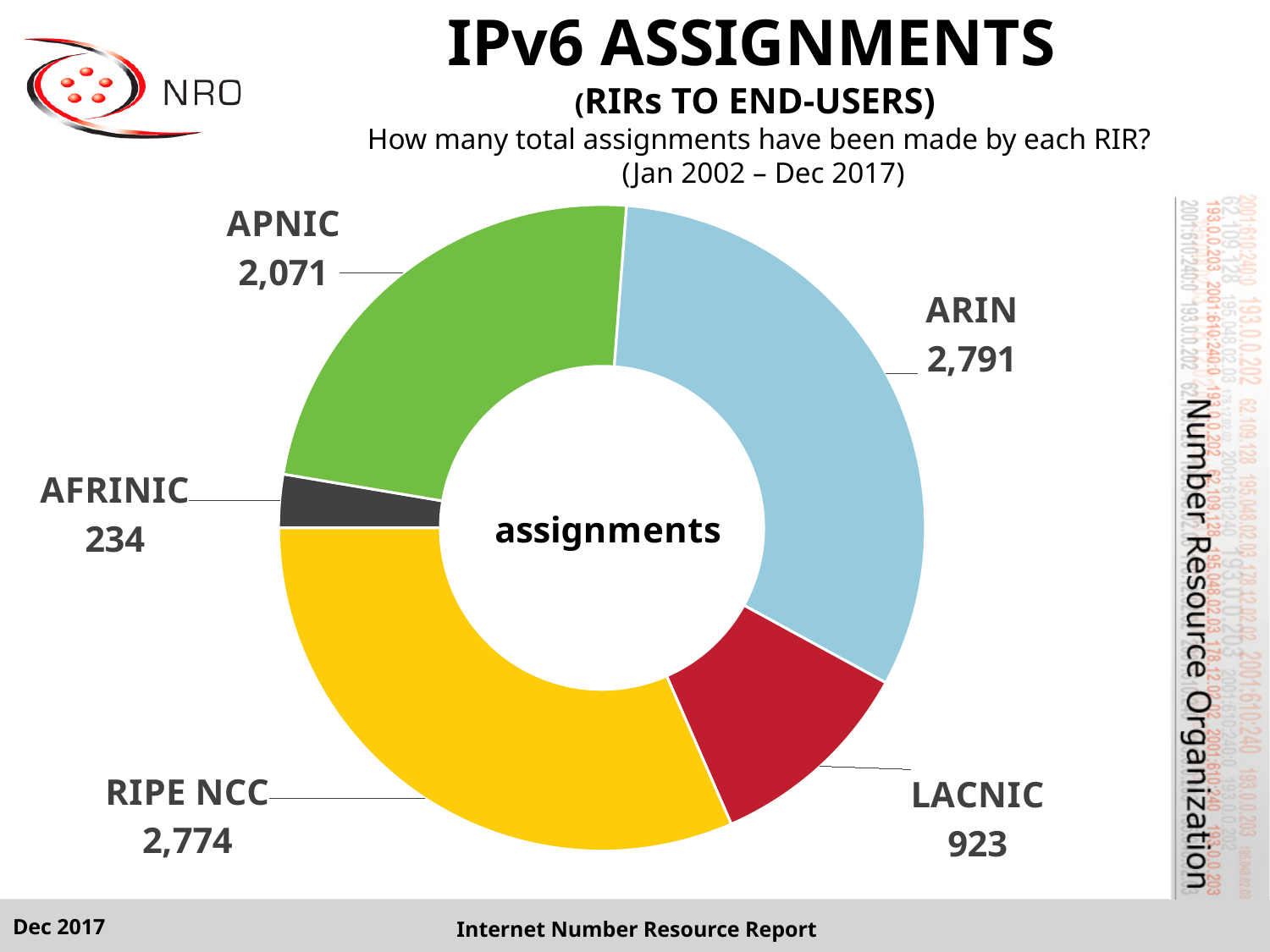
Which RIR has the highest number of assignments? ARIN What colour is the RIPE NCC segment of the chart? Yellow How many RIRs are shown in the chart? 5 What is the number of assignments shown for LACNIC? 923 How many assignments are shown for APNIC? 2,071 What value is shown for AFRINIC? 234 What is the difference between the assignments of ARIN and RIPE NCC? 17 How many more assignments has APNIC made than LACNIC? 1,148 Which RIR has the lowest number of assignments? AFRINIC Which has more assignments, RIPE NCC or APNIC? RIPE NCC What type of chart is used on this slide? Doughnut chart How many IPv6 assignments has ARIN made according to the chart? 2,791